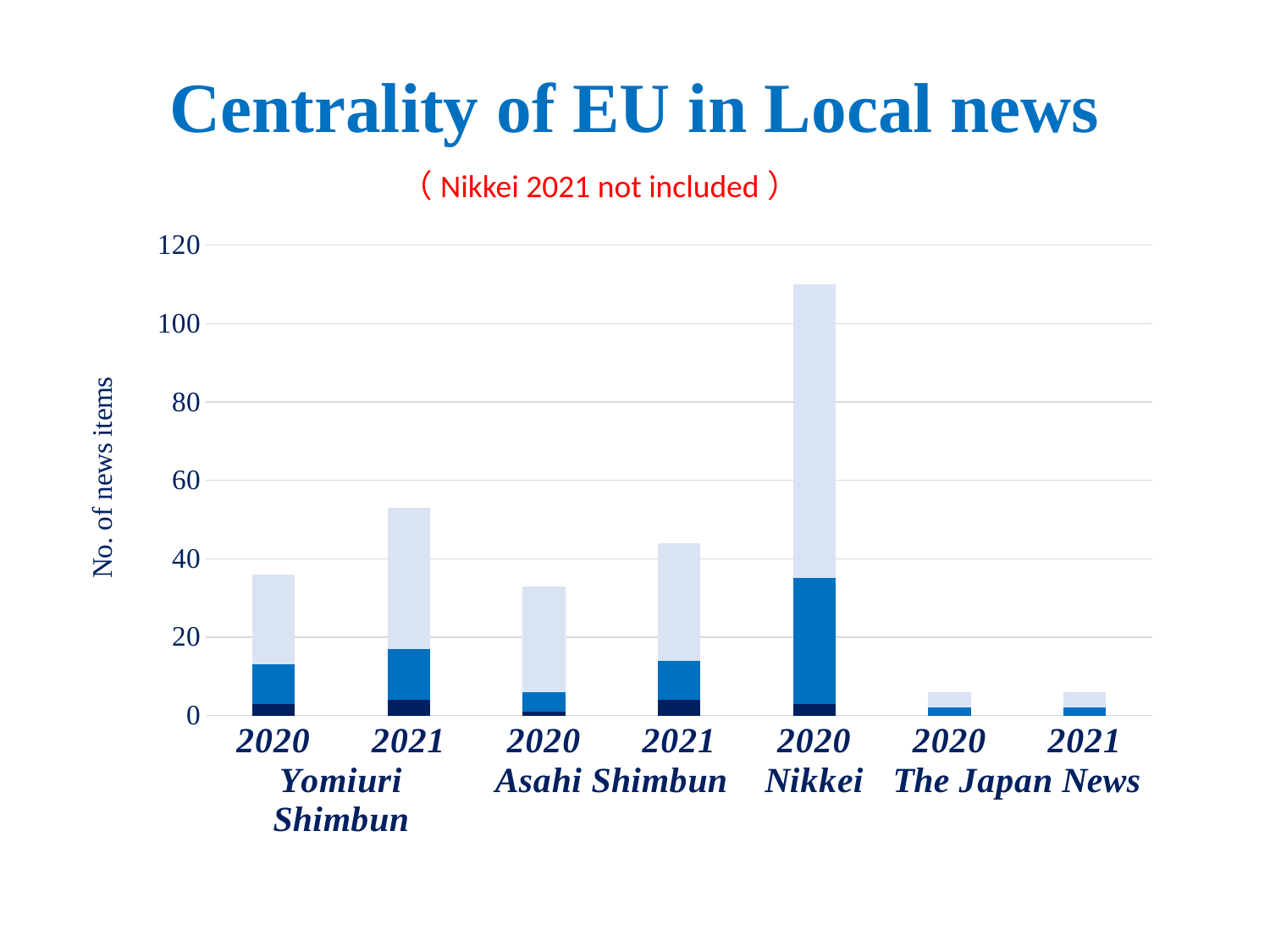
Which is larger, the total for Yomiuri Shimbun 2020 or Yomiuri Shimbun 2021? Yomiuri Shimbun 2021 Is the total value for The Japan News 2020 greater or less than 20? less Which is larger, the total for Asahi Shimbun 2020 or Asahi Shimbun 2021? Asahi Shimbun 2021 Is the total value for Asahi Shimbun 2020 greater or less than 40? less What is the label on the vertical axis? No. of news items Is the total value for Nikkei 2020 greater or less than 100? greater Which bar has the highest total number of news items? Nikkei 2020 How many bars are plotted in the chart? 7 What kind of chart is shown on the slide? Stacked bar chart What is the title of the chart? Centrality of EU in Local news